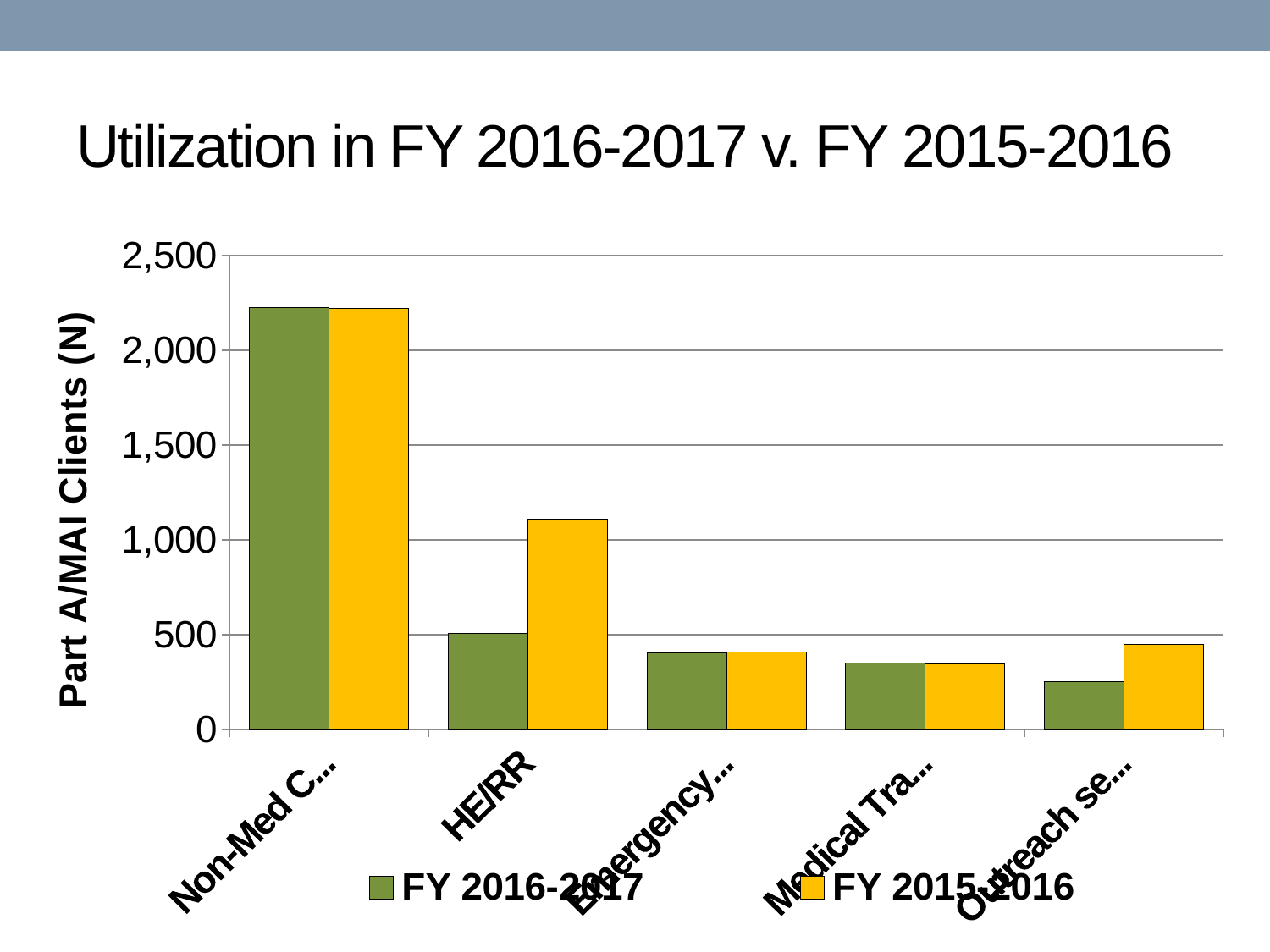
Is the FY 2016-2017 value for Non-Med C... greater or less than 2,000? greater What kind of chart is shown on the slide? bar chart Which colour represents the FY 2016-2017 series? green How many categories are shown on the x axis? 5 How many series does the legend list? 2 Is the FY 2016-2017 value for Outreach se... greater or less than 500? less Which category has the lowest FY 2016-2017 value? Outreach se... Which category has the highest FY 2015-2016 value? Non-Med C... For HE/RR, which series has the larger value, FY 2016-2017 or FY 2015-2016? FY 2015-2016 Is the FY 2015-2016 value for HE/RR greater or less than 1,000? greater What is the label of the vertical axis? Part A/MAI Clients (N)